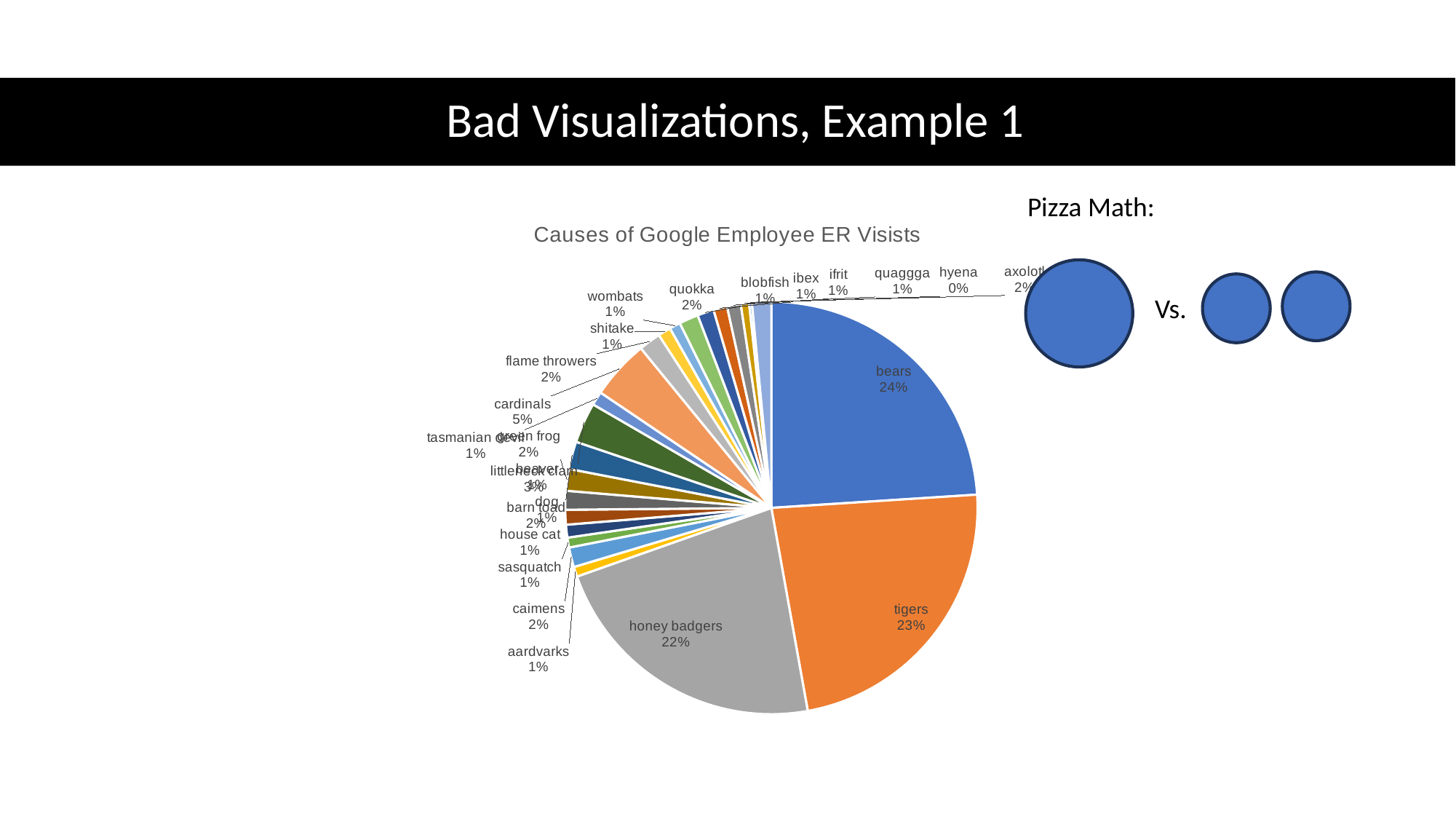
What percentage is shown for tigers? 23% What share of the pie do bears account for? 24% Which category has the largest share of the pie? bears What kind of chart is shown on the slide? pie chart What percentage is shown for hyena? 0% What percentage is shown for cardinals? 5% What is the title of the pie chart? Causes of Google Employee ER Visists Which is larger, the share for tigers or the share for honey badgers? tigers What percentage is shown for honey badgers? 22% What is the difference in percentage points between cardinals and quokka? 3% What percentage is shown for flame throwers? 2% What is the difference in percentage points between bears and tigers? 1%